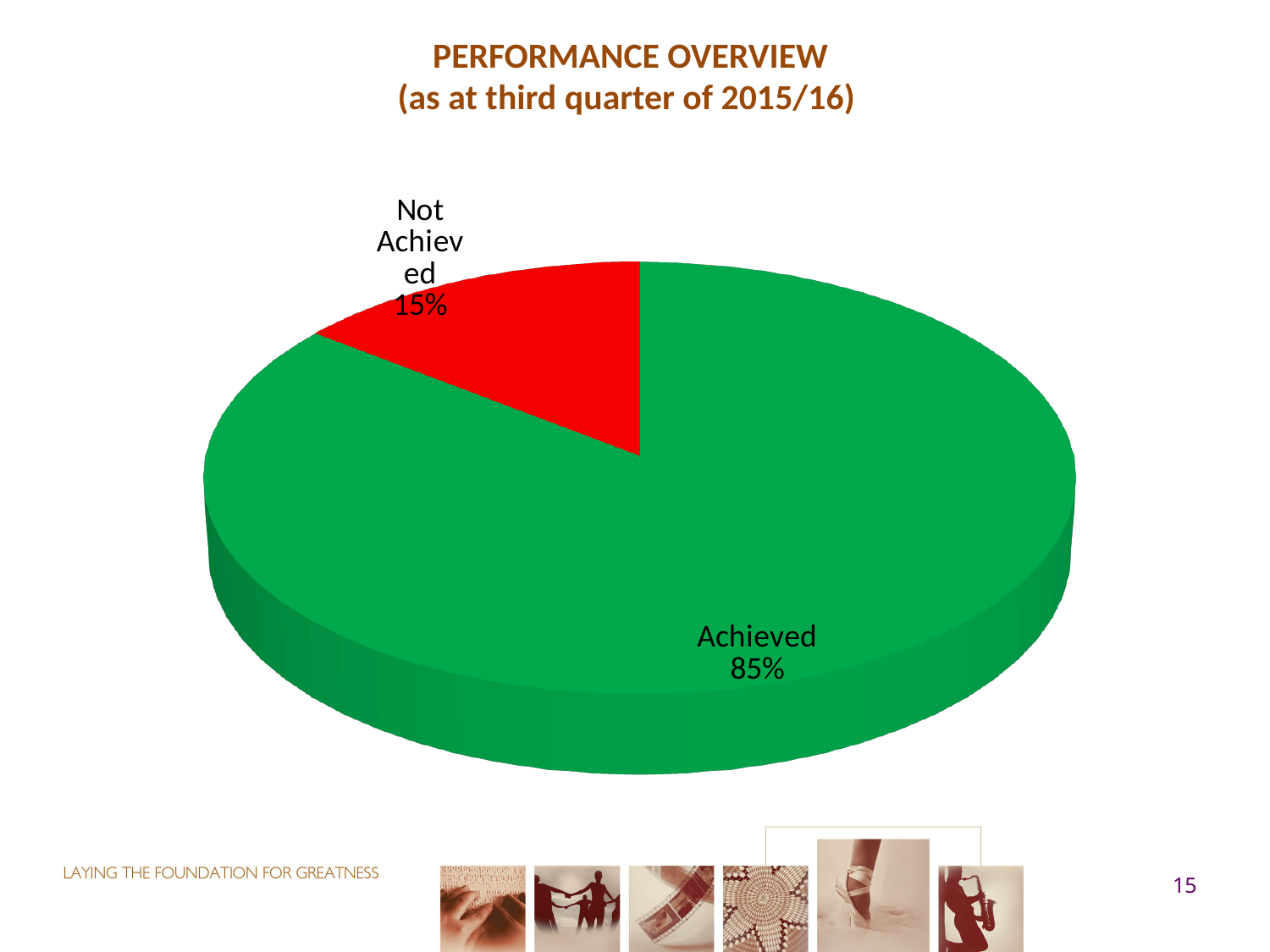
Which slice of the pie is the smallest? Not Achieved What share of the pie does the Not Achieved slice represent? 15% What is the difference in percentage points between the Achieved and Not Achieved slices? 70 What kind of chart is shown on the slide? Pie chart What percentage of the pie is labelled Achieved? 85% Which slice of the pie is the largest? Achieved What colour is the Not Achieved slice? Red Which is larger, the Achieved slice or the Not Achieved slice? Achieved What percentage of the pie is labelled Not Achieved? 15% How many slices does the pie chart have? 2 What is the title of the chart on the slide? PERFORMANCE OVERVIEW (as at third quarter of 2015/16)